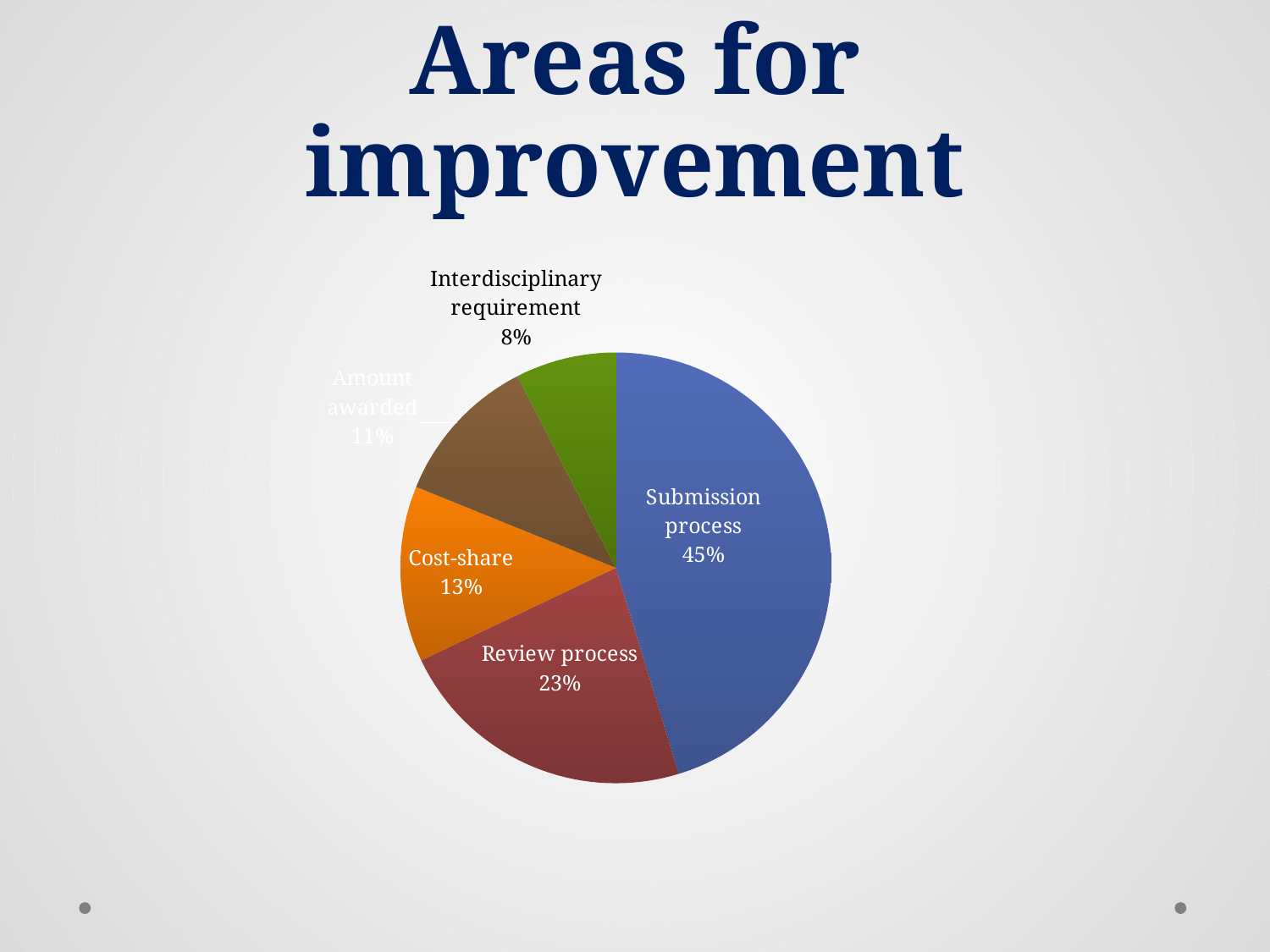
How many slices does the pie chart have? 5 Which area has the smallest slice of the pie? Interdisciplinary requirement What share of the pie does Cost-share account for? 13% Which area has the largest slice of the pie? Submission process Which is larger, the Cost-share slice or the Interdisciplinary requirement slice? Cost-share What share of the pie does Review process account for? 23% What share of the pie does Interdisciplinary requirement account for? 8% What kind of chart is shown on the slide? Pie chart What is the title of the slide containing the pie chart? Areas for improvement What is the difference in percentage points between Submission process and Review process? 22